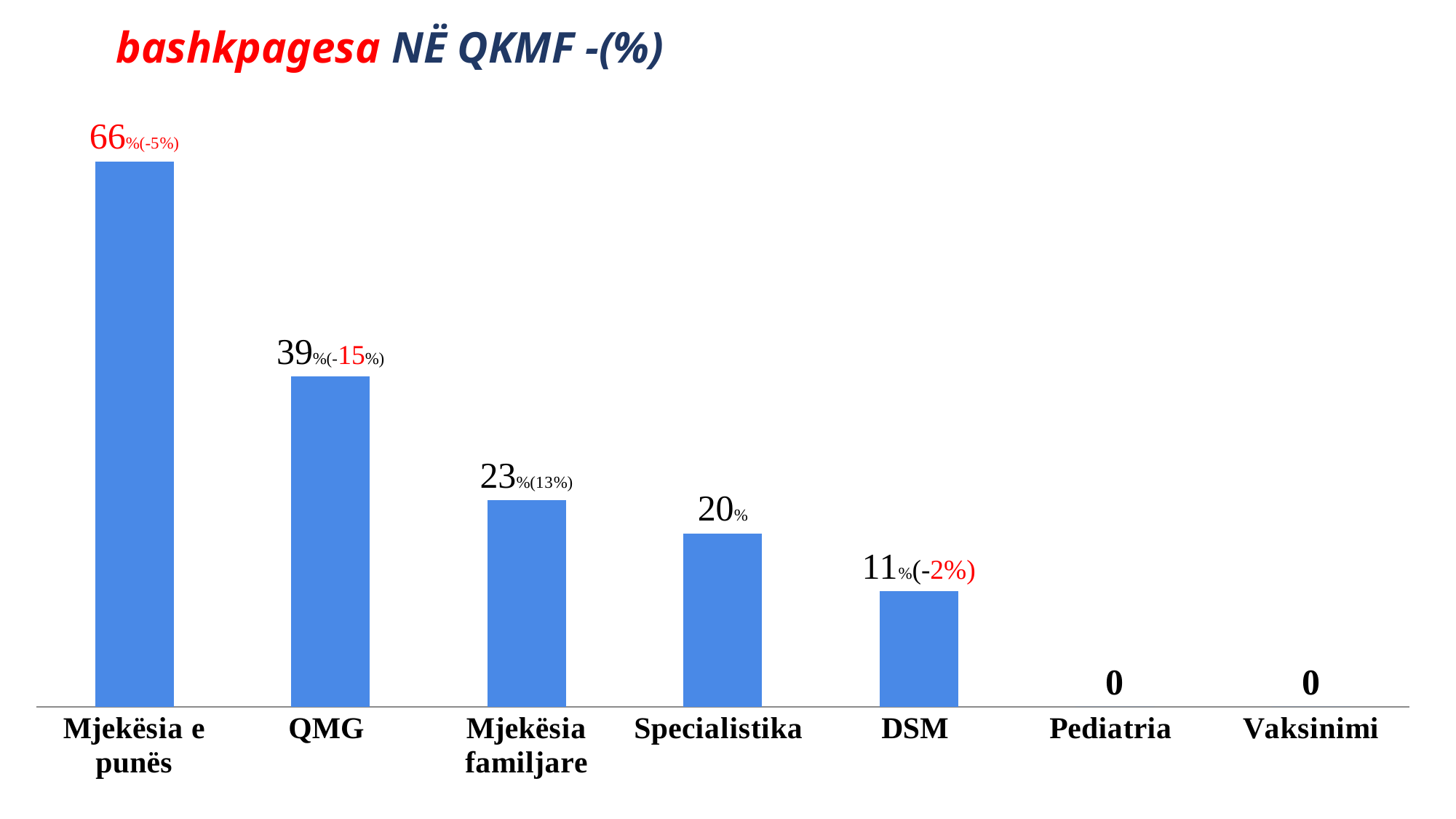
What is the value for DSM? 11% Do the values rise or fall from left to right along the x axis? fall How many categories are shown on the x axis? 7 What is the value for Specialistika? 20% What kind of chart is this? bar chart What is the value for QMG? 39% What is the difference between the values for Mjekësia e punës and QMG? 27% Which category has the highest value? Mjekësia e punës What is the value for Mjekësia e punës? 66% What is the difference between the values for Mjekësia familjare and DSM? 12% What is the value for Pediatria? 0 Which is larger, the value for Mjekësia familjare or the value for Specialistika? Mjekësia familjare